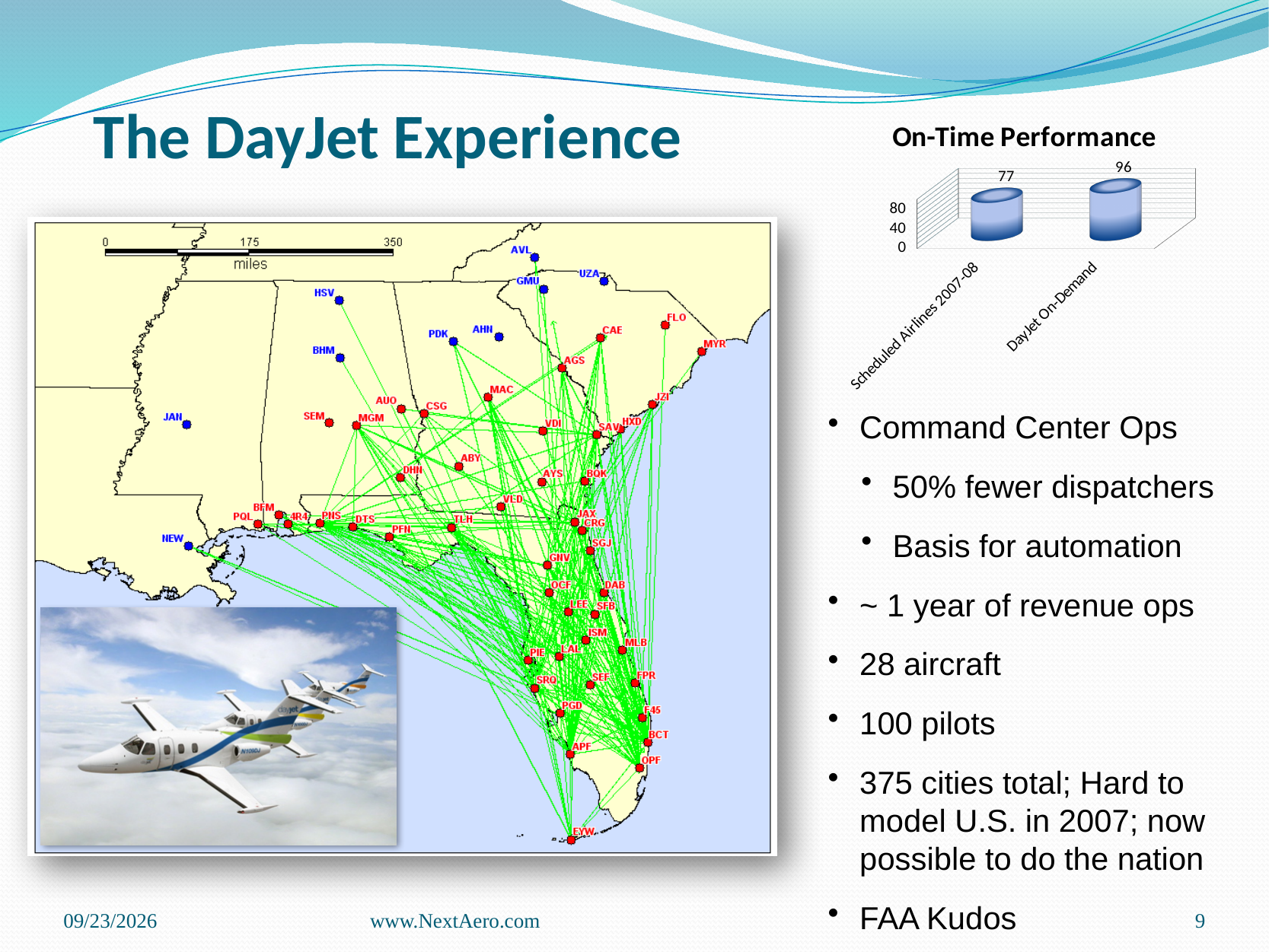
What kind of chart is the On-Time Performance chart? bar chart What is the title of the chart on the slide? On-Time Performance Is the value for DayJet On-Demand greater or less than 80? greater Which is larger, the value for Scheduled Airlines 2007-08 or the value for DayJet On-Demand? DayJet On-Demand What is the difference between the DayJet On-Demand value and the Scheduled Airlines 2007-08 value? 19 Is the value for Scheduled Airlines 2007-08 greater or less than 80? less What is the on-time performance value for Scheduled Airlines 2007-08? 77 Which category has the highest value in the On-Time Performance chart? DayJet On-Demand What is the highest tick value shown on the vertical axis of the On-Time Performance chart? 80 What is the on-time performance value for DayJet On-Demand? 96 Which category has the lowest value in the On-Time Performance chart? Scheduled Airlines 2007-08 How many categories are shown in the On-Time Performance chart? 2